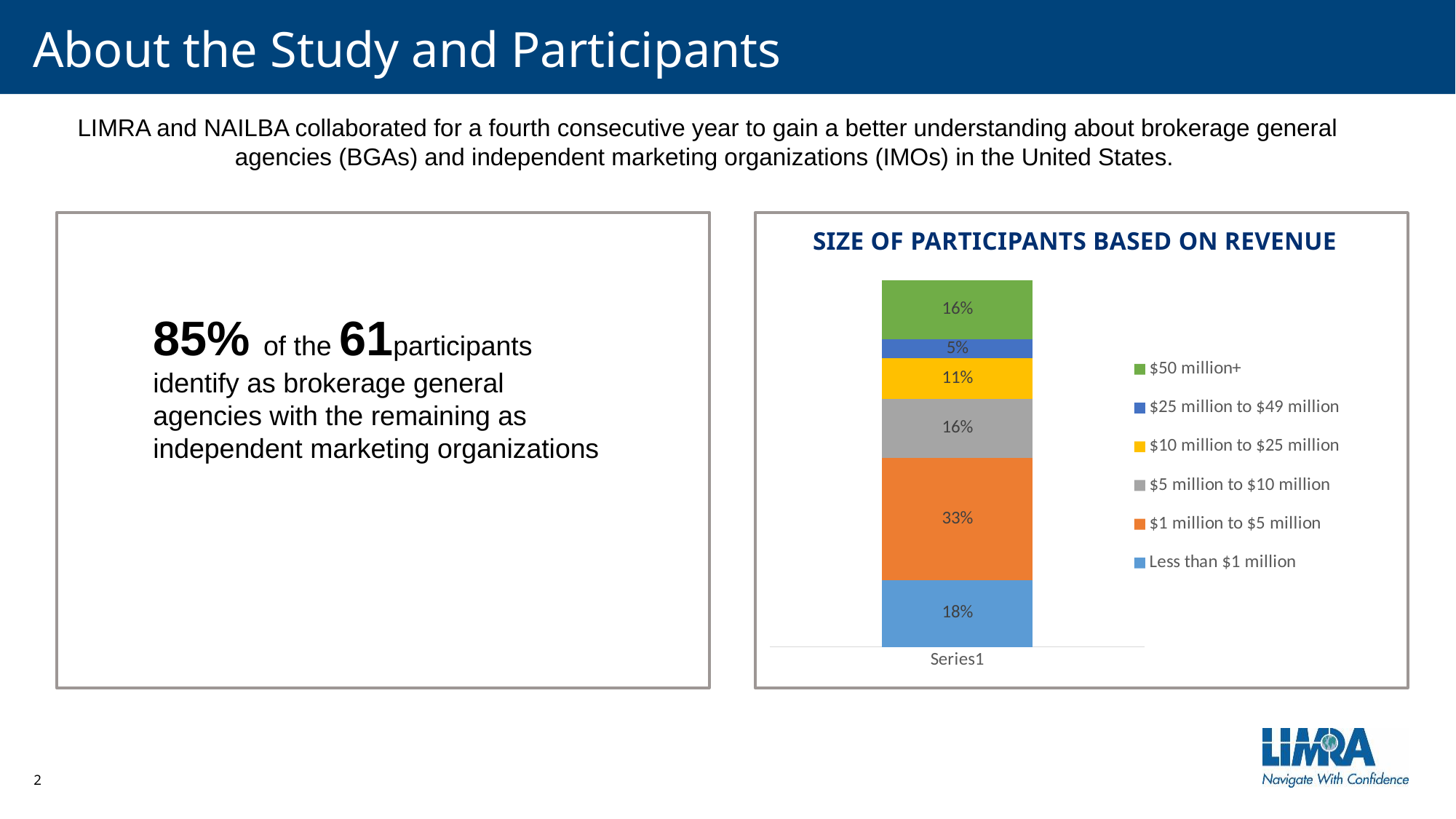
Which revenue category has the smallest share of participants? $25 million to $49 million How many bars are plotted in the chart? 1 Which is larger: the share for $50 million+ or the share for $10 million to $25 million? $50 million+ Which revenue category has the largest share of participants? $1 million to $5 million What percentage of participants have revenue of $1 million to $5 million? 33% What is the difference between the share for $1 million to $5 million and the share for Less than $1 million? 15% What kind of chart is shown on the slide? Stacked bar chart How many series does the chart's legend list? 6 What percentage of participants have revenue of less than $1 million? 18% What percentage of participants have revenue of $25 million to $49 million? 5% What percentage of participants have revenue of $10 million to $25 million? 11% What is the title of the chart? SIZE OF PARTICIPANTS BASED ON REVENUE